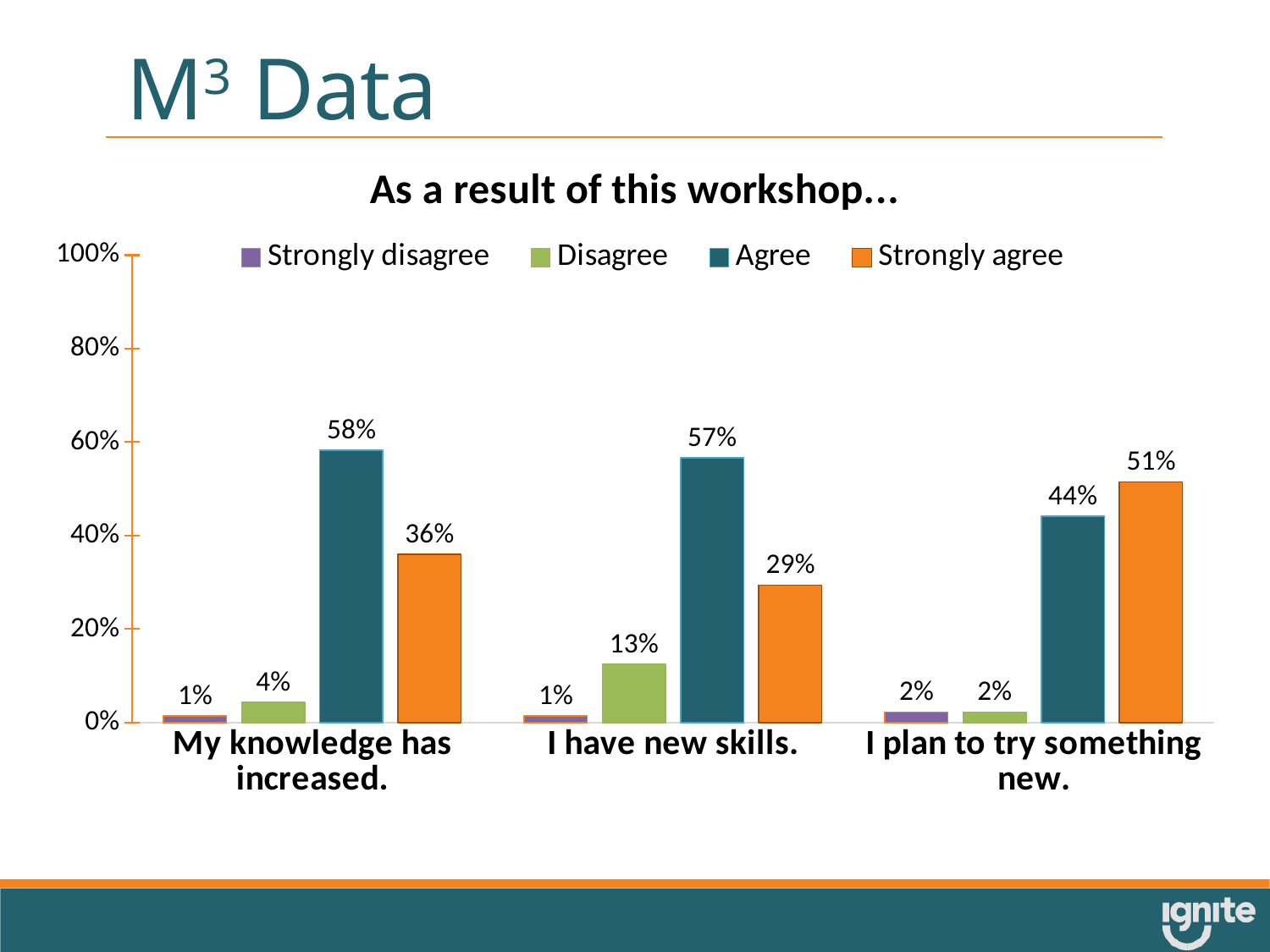
Which is larger for "I plan to try something new.": Agree or Strongly agree? Strongly agree Which category has the highest Strongly agree value? I plan to try something new. What is the value for Disagree in the "I have new skills." category? 13% Is the Strongly agree value for "My knowledge has increased." greater or less than 40%? less How many series does the legend list? 4 What is the difference between the Agree and Strongly agree values for "I have new skills."? 28% What is the value for Strongly agree in the "I plan to try something new." category? 51% What is the value for Agree in the "My knowledge has increased." category? 58% Which category has the lowest Agree value? I plan to try something new. What kind of chart is shown on the slide? Bar chart What is the title of the chart? As a result of this workshop… How many categories are shown on the x axis? 3